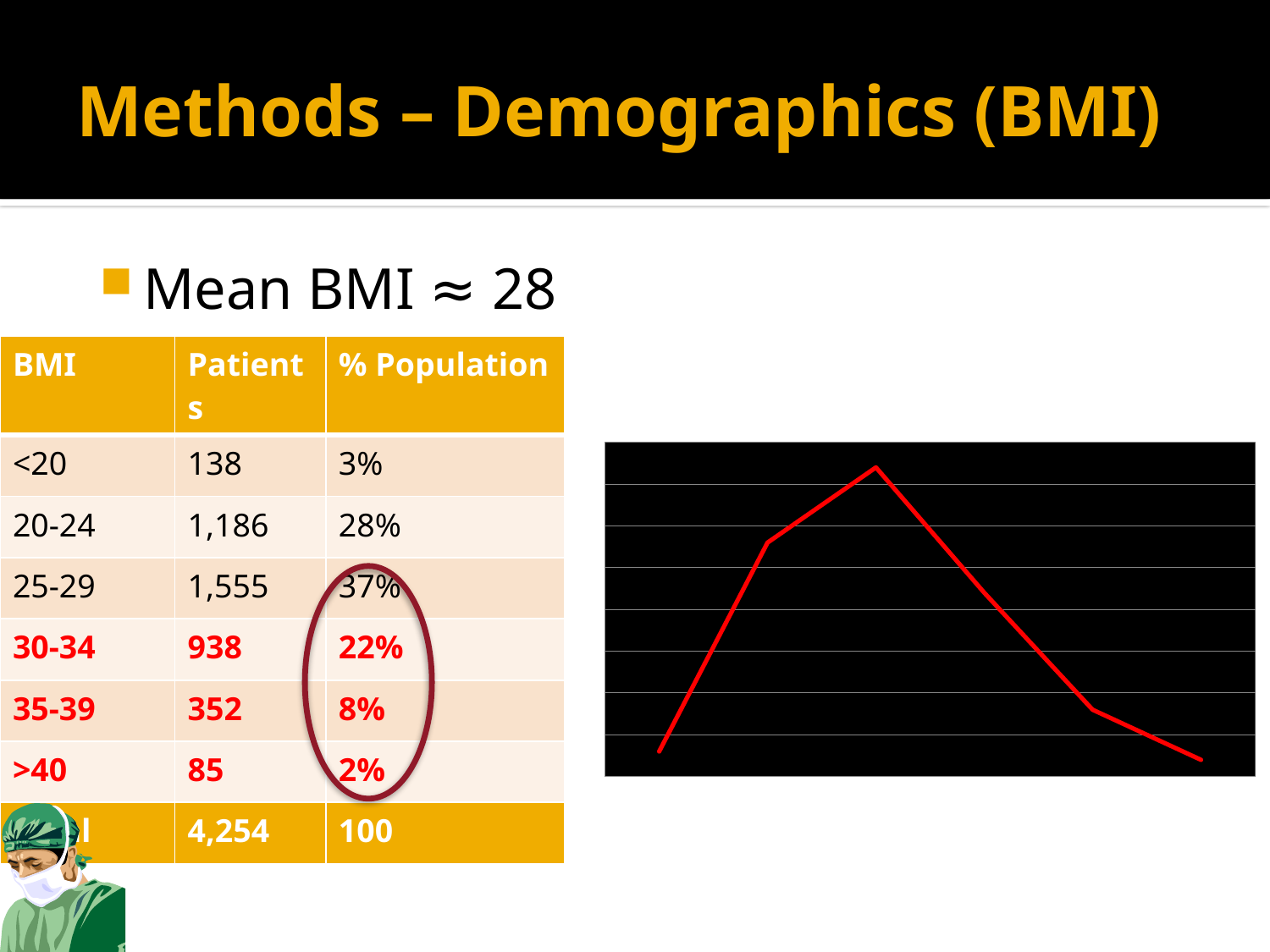
In the chart on the right, does the line rise or fall from its peak to the right end? fall In the chart on the right, does the line rise or fall from its left end to its peak? rise What is the background colour of the plot area in the chart on the right? black What kind of chart is shown on the right side of the slide? line chart What colour is the line plotted in the chart on the right? red